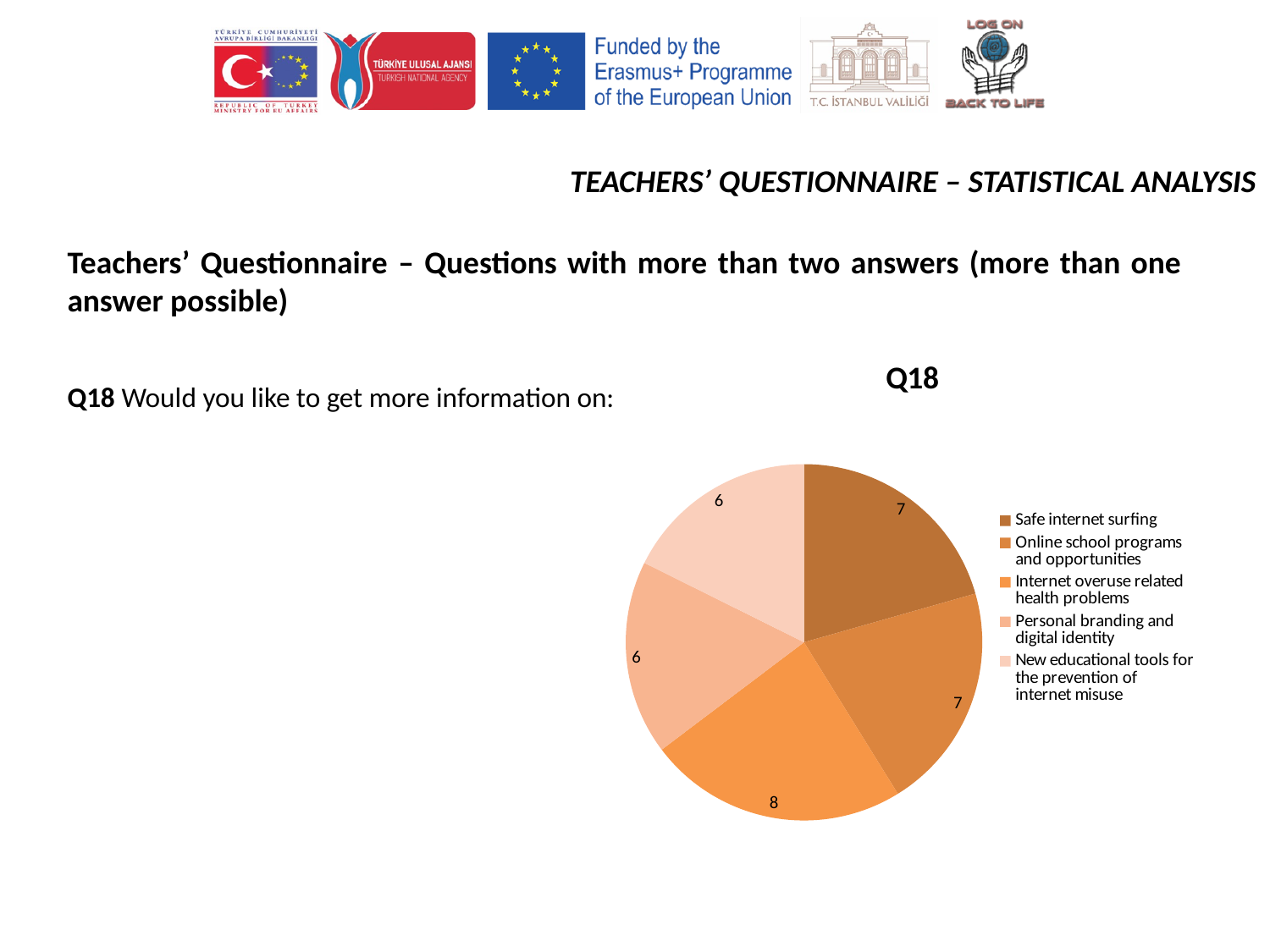
What is the value for New educational tools for the prevention of internet misuse? 6 What is the total of all the slices in the pie chart? 34 What is the value for Online school programs and opportunities? 7 What is the difference between the values for Internet overuse related health problems and Personal branding and digital identity? 2 Which is larger, the value for Safe internet surfing or the value for New educational tools for the prevention of internet misuse? Safe internet surfing What is the value for Internet overuse related health problems? 8 Which category has the largest slice of the pie? Internet overuse related health problems What is the value for Personal branding and digital identity? 6 What is the title of the chart? Q18 How many categories does the legend of the pie chart list? 5 What is the value for Safe internet surfing? 7 What kind of chart is shown on the slide? pie chart